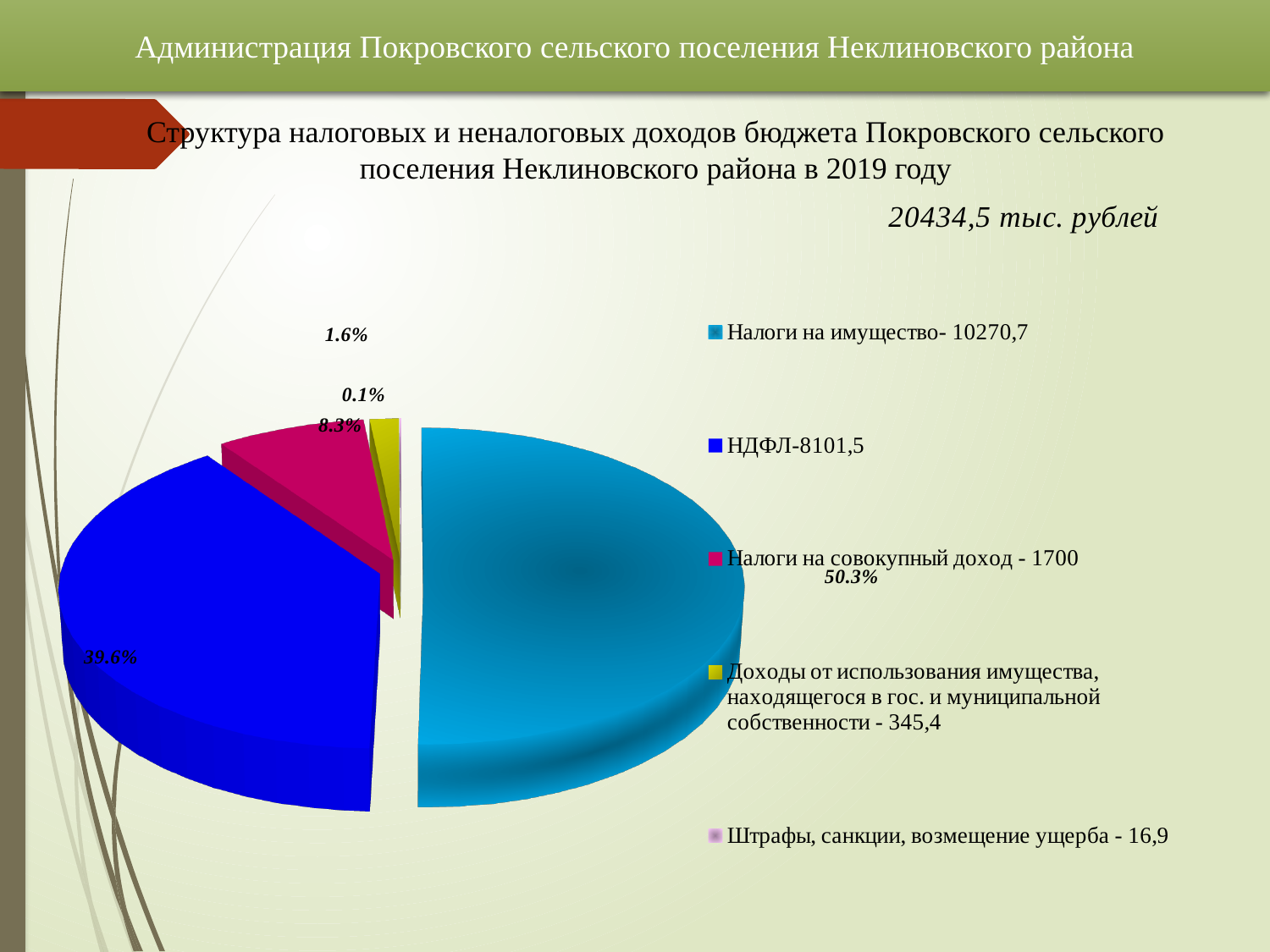
What share of the pie is labelled for Штрафы, санкции, возмещение ущерба? 0.1% Which category has the smallest slice of the pie? Штрафы, санкции, возмещение ущерба What kind of chart is shown on the slide? pie chart What share of the pie is labelled for НДФЛ? 39.6% Which category has the largest slice of the pie? Налоги на имущество What total amount in thousand rubles is stated above the chart? 20434,5 тыс. рублей What value does the legend give for НДФЛ? 8101,5 How many entries does the legend list? 5 What share of the pie is labelled for Налоги на имущество? 50.3% How many slices does the pie chart have? 5 What is the difference in percentage points between the Налоги на имущество slice (50.3%) and the НДФЛ slice (39.6%)? 10.7